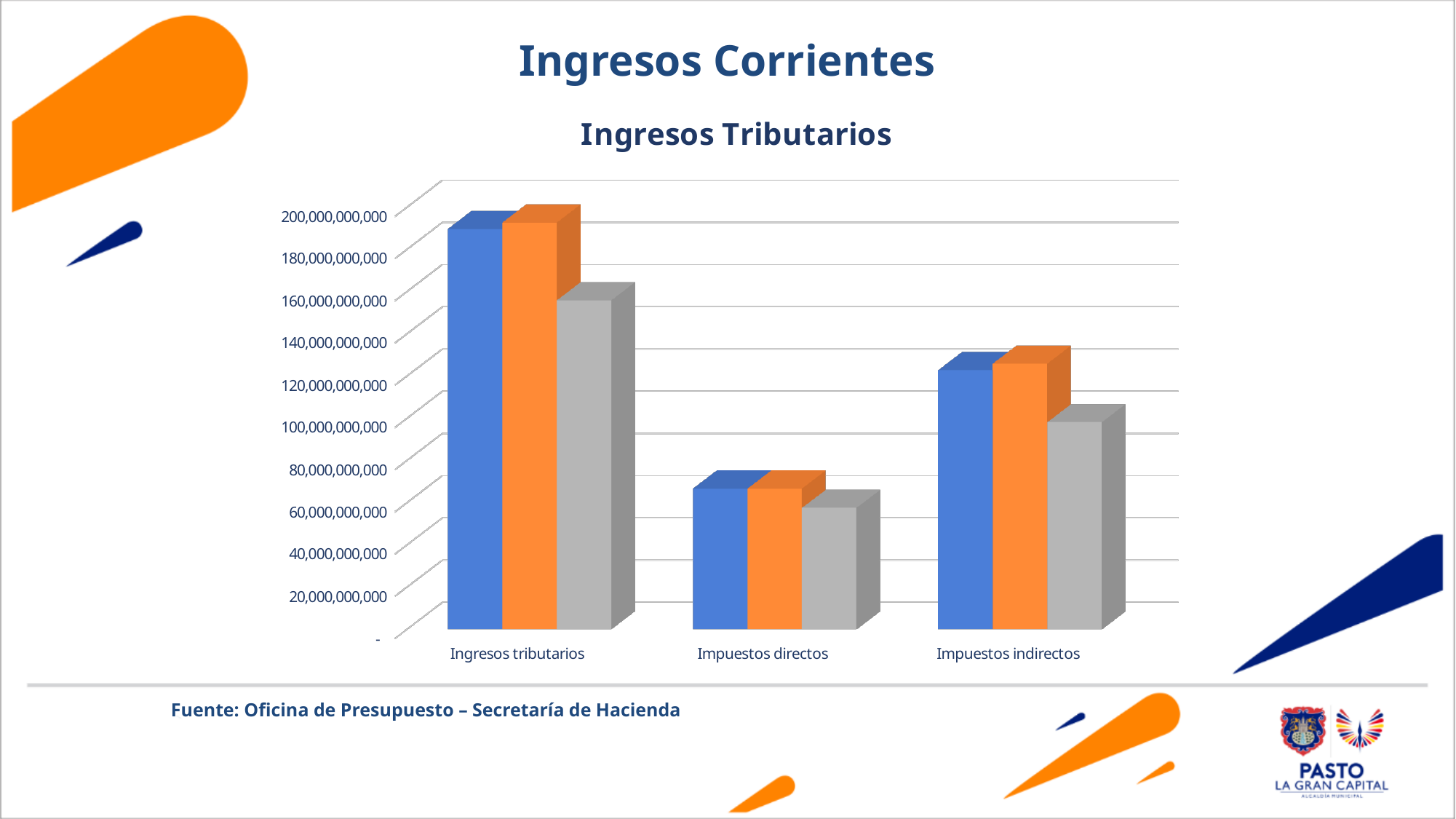
Is the value of the blue bar for Ingresos tributarios greater or less than 160,000,000,000? greater Within each category, which coloured bar is the shortest? grey Is the value of the blue bar for Impuestos indirectos greater or less than 100,000,000,000? greater How many bars are plotted for each category in the chart? 3 Which category has larger values, Impuestos directos or Impuestos indirectos? Impuestos indirectos What is the title of the chart? Ingresos Tributarios Which category has the shortest bars in the chart? Impuestos directos How many categories are shown on the x axis of the chart? 3 Is the value of the grey bar for Ingresos tributarios greater or less than 180,000,000,000? less What kind of chart is shown on the slide? bar chart Which category has the tallest bars in the chart? Ingresos tributarios